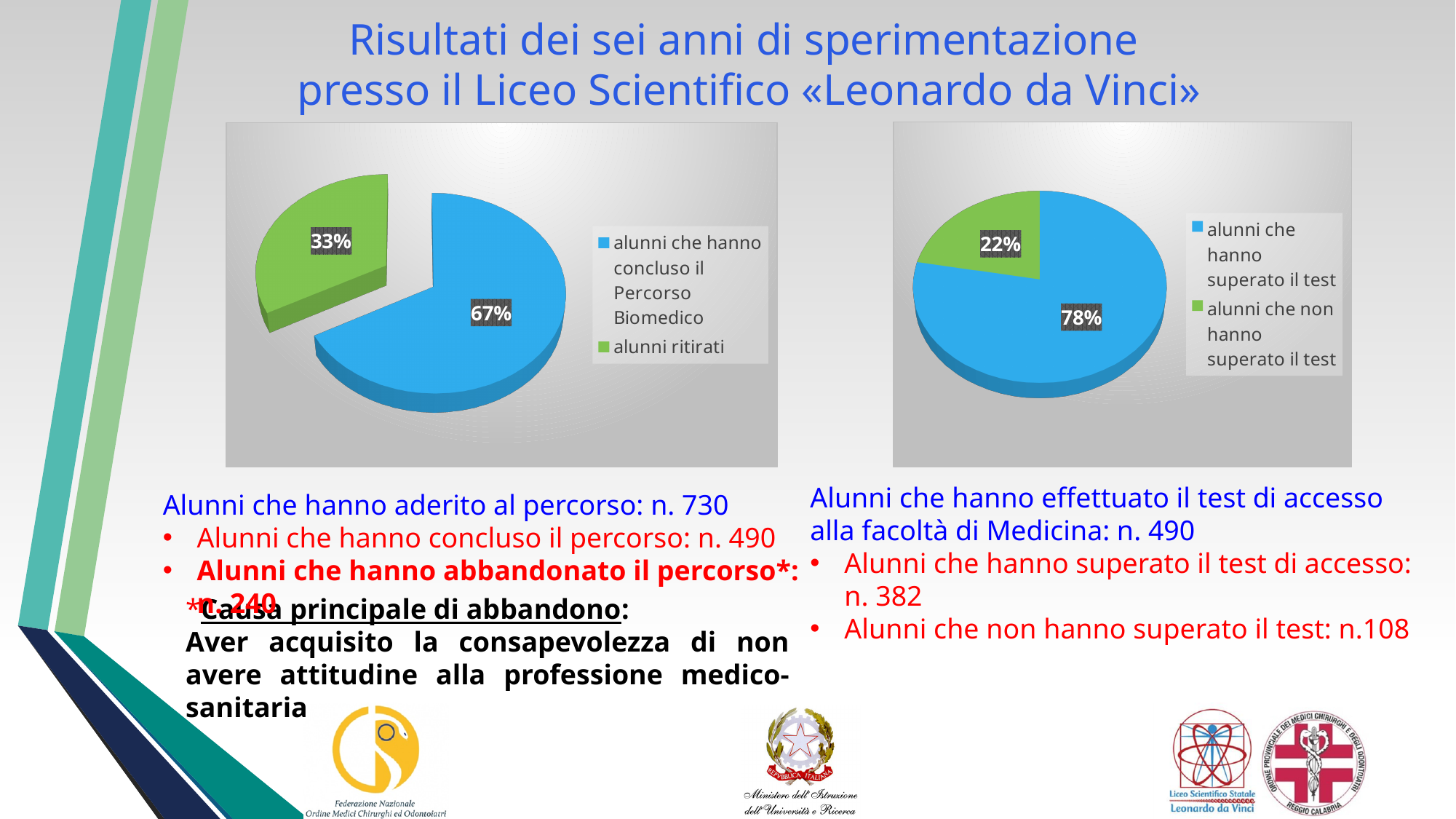
In the left pie chart, what colour is the slice for 'alunni ritirati'? green In the right pie chart, what share is shown for 'alunni che non hanno superato il test'? 22% In the right pie chart, what is the difference in percentage points between 'alunni che hanno superato il test' and 'alunni che non hanno superato il test'? 56 In the left pie chart, what share is shown for 'alunni ritirati'? 33% What type of chart is the right chart on the slide? pie chart In the right pie chart, which category has the smallest slice? alunni che non hanno superato il test In the right pie chart, what share is shown for 'alunni che hanno superato il test'? 78% In the left pie chart, which category has the largest slice? alunni che hanno concluso il Percorso Biomedico How many slices does the left pie chart have? 2 In the right pie chart, which is larger: the slice for 'alunni che hanno superato il test' or the slice for 'alunni che non hanno superato il test'? alunni che hanno superato il test In the left pie chart, what share is shown for 'alunni che hanno concluso il Percorso Biomedico'? 67% In the left pie chart, what is the difference in percentage points between the two slices? 34